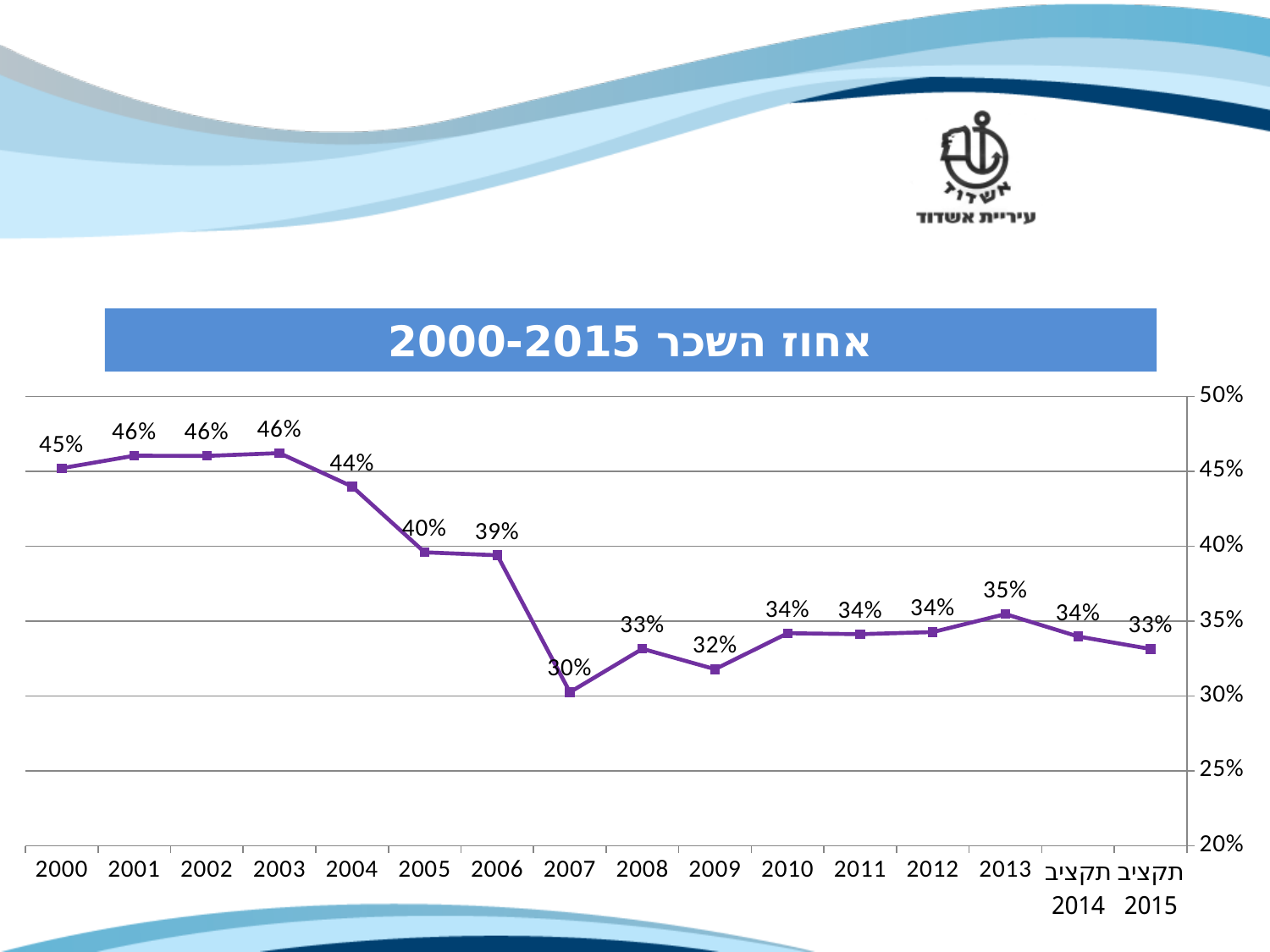
Which is larger, the value for 2005 or the value for 2009? 2005 Is the value for 2004 greater or less than 40%? greater How many data points are plotted on the chart? 16 What is the highest value shown on the chart? 46% What is the value for 2007? 30% What is the value for 2013? 35% What type of chart is shown on the slide? line chart What is the value for תקציב 2015? 33% What is the value for 2000? 45% Which year has the lowest value? 2007 What is the title of the chart? אחוז השכר 2000-2015 What is the difference between the values for 2003 and 2007? 16%